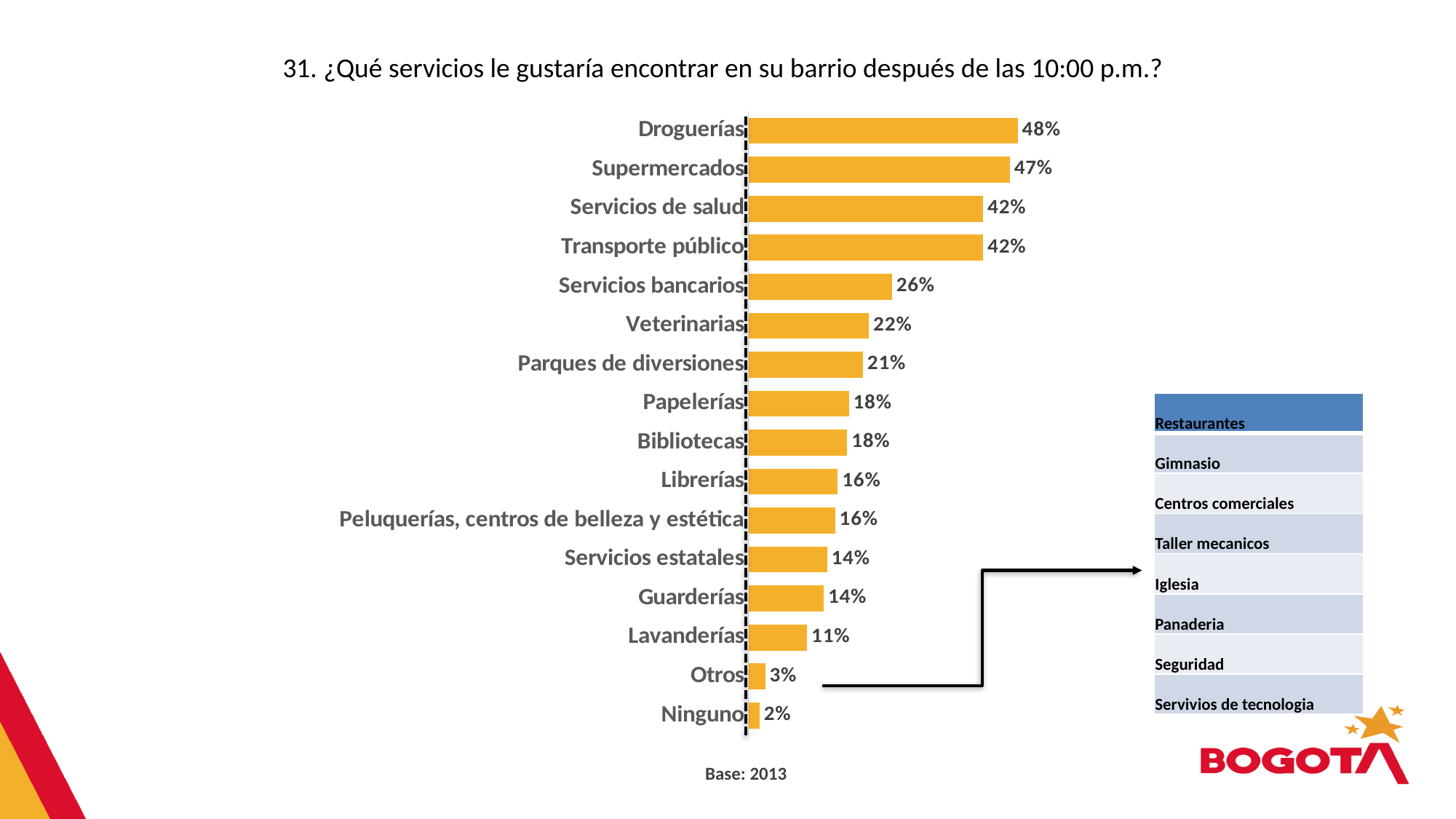
What is the value shown for Lavanderías? 11% Which service has the highest percentage in the chart? Droguerías How many categories are shown in the bar chart? 16 Which has a larger value, Servicios bancarios or Parques de diversiones? Servicios bancarios Which category has the lowest percentage in the chart? Ninguno What colour are the bars in the chart? Orange What is the difference between the values for Supermercados and Veterinarias? 25% What percentage of respondents would like to find Droguerías in their neighbourhood after 10:00 p.m.? 48% What is the base (sample size) noted below the chart? 2013 What is the value shown for Servicios bancarios? 26% What kind of chart is shown on the slide? Bar chart What is the difference between the values for Droguerías and Ninguno? 46%